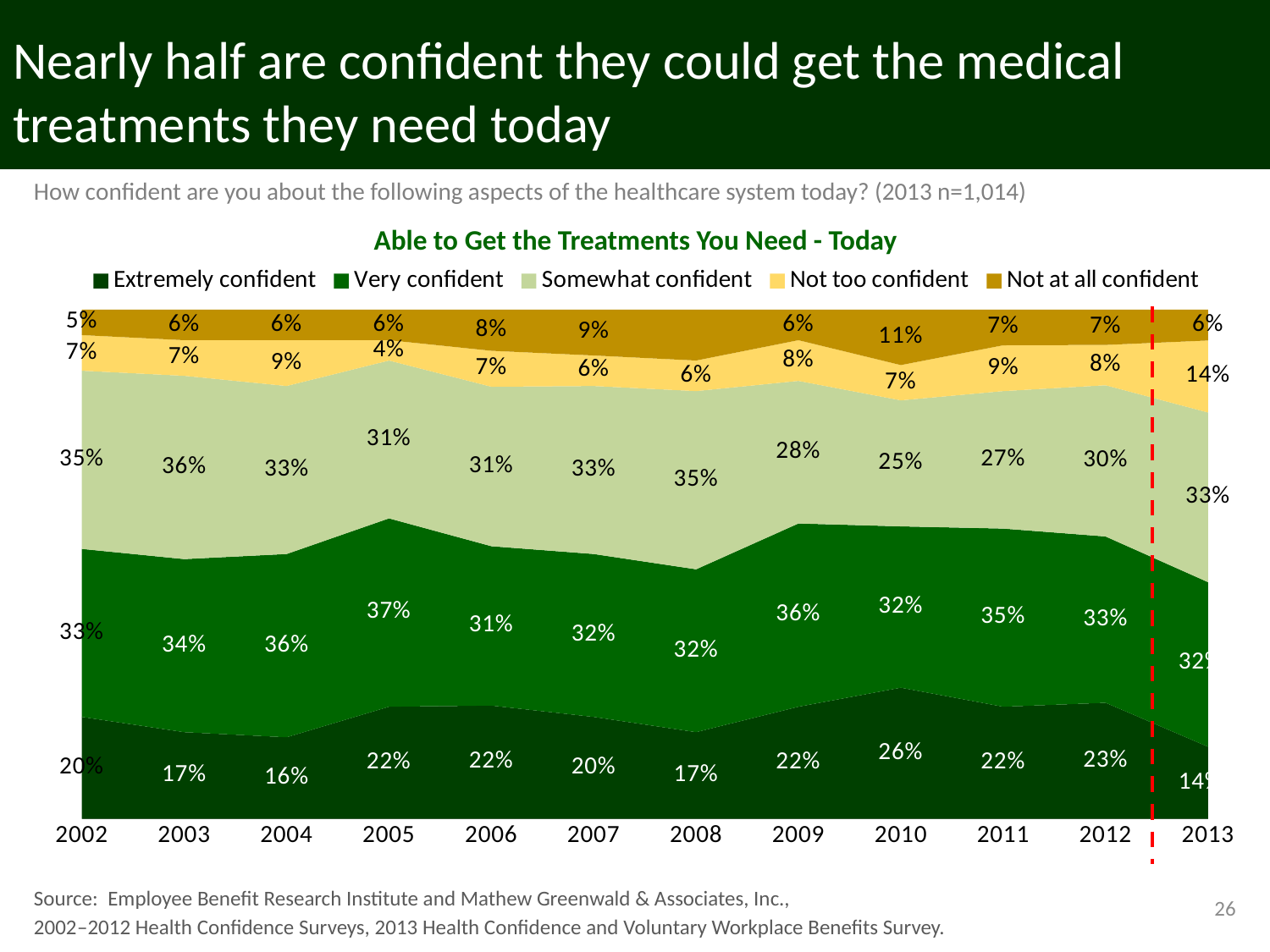
How many series does the legend list? 5 In which year is the Not too confident value lowest? 2005 What is the difference between the Somewhat confident values in 2002 and 2010? 10 percentage points What is the value for Somewhat confident in 2009? 28% What is the value for Not at all confident in 2010? 11% What is the value for Extremely confident in 2010? 26% What is the title of the chart? Able to Get the Treatments You Need - Today Which year has the larger Very confident value, 2005 or 2006? 2005 What kind of chart is shown on the slide? Stacked area chart In which year is the Extremely confident value highest? 2010 How many years are shown along the x axis? 12 What is the value for Not too confident in 2013? 14%